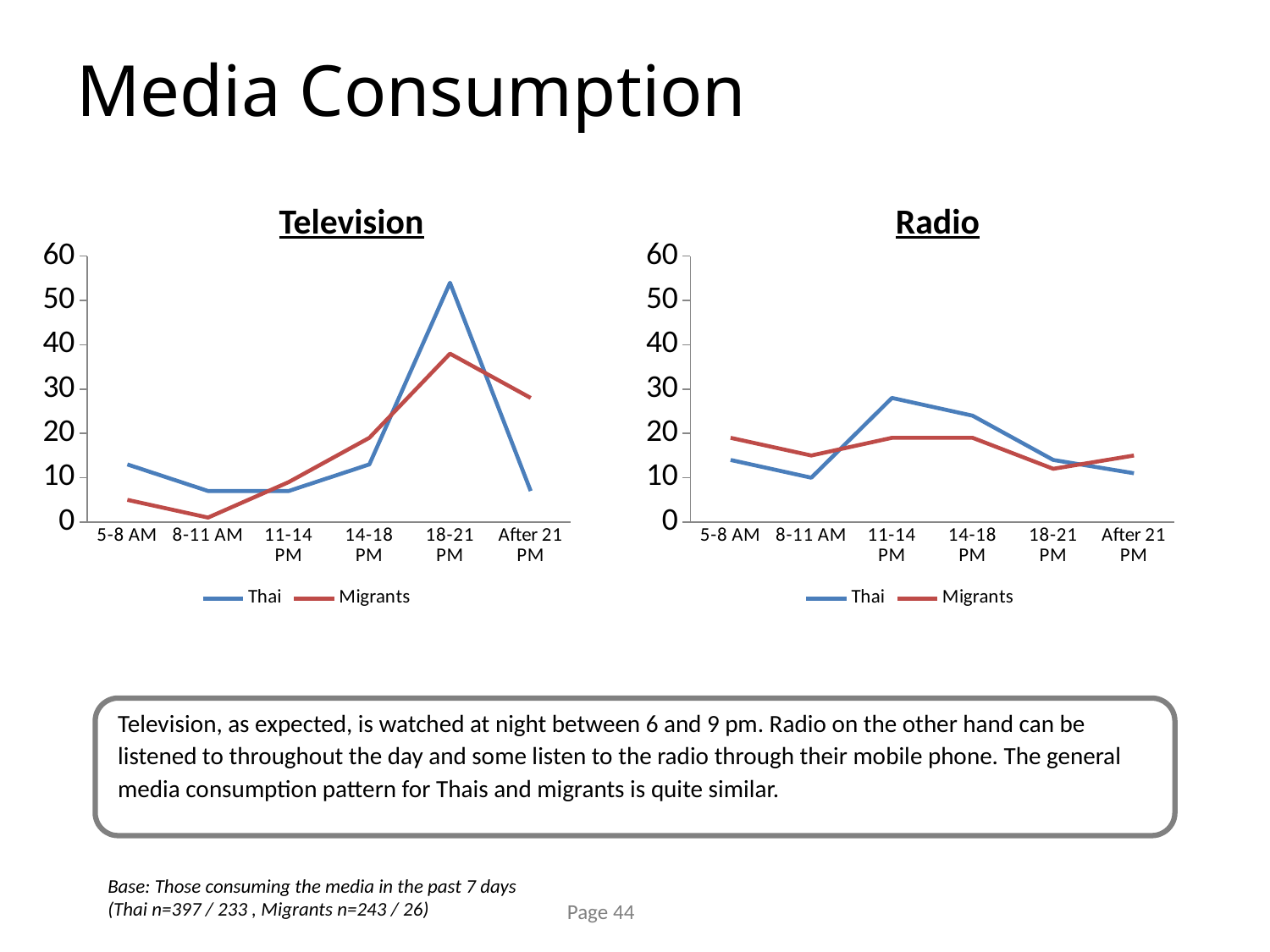
In the Television chart, which series has the larger value at After 21 PM, Thai or Migrants? Migrants In the Radio chart, which series has the larger value at 5-8 AM, Thai or Migrants? Migrants How many time slots are shown on the x axis of the Television chart? 6 In the Television chart, does the Thai series rise or fall from 14-18 PM to 18-21 PM? rise In the Radio chart, is the Thai value for 11-14 PM greater or less than 20? greater In the Television chart, is the Thai value for 18-21 PM greater or less than 50? greater How many series does the legend of the Radio chart list? 2 In the Television chart, is the Migrants value for 8-11 AM greater or less than 10? less In the Television chart, at which time slot is the Migrants series lowest? 8-11 AM In the Television chart, at which time slot is the Thai series highest? 18-21 PM What kind of chart is the Television chart? line chart In the Radio chart, at which time slot is the Thai series highest? 11-14 PM